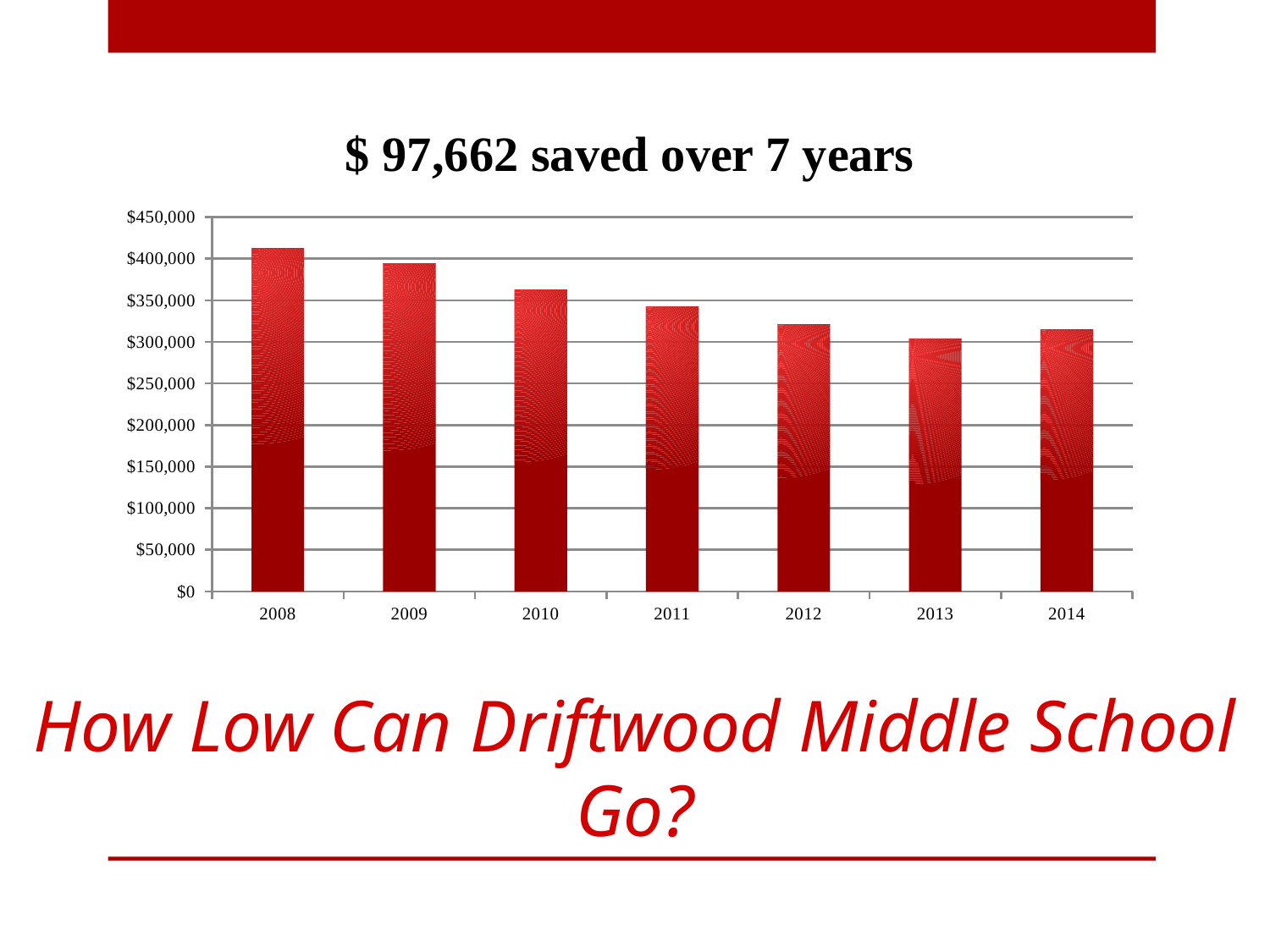
Which year has the highest value in the chart? 2008 Which year has the lowest value in the chart? 2013 What kind of chart is shown on the slide? bar chart Is the value for 2012 greater or less than $300,000? greater Is the value for 2010 greater or less than $350,000? greater Is the value for 2013 greater or less than $350,000? less Do the values generally rise or fall from 2008 to 2014? fall How many years are shown on the x axis of the chart? 7 What is the title of the chart? $ 97,662 saved over 7 years Which year has the larger value, 2008 or 2009? 2008